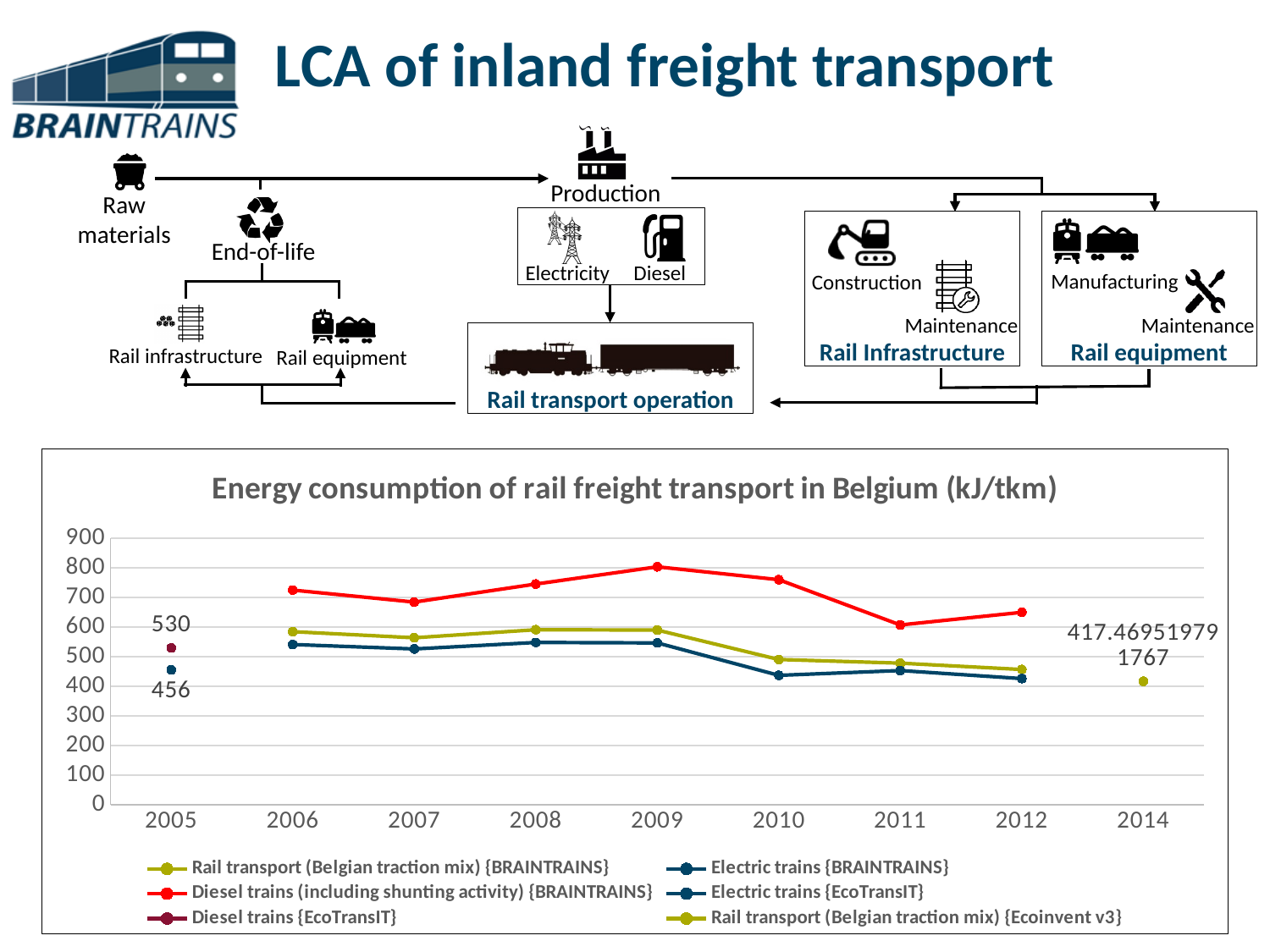
What is the difference between the Diesel trains {EcoTransIT} and Electric trains {EcoTransIT} values in 2005? 74 What is the value for Diesel trains {EcoTransIT} in 2005? 530 In which year does the Diesel trains (including shunting activity) {BRAINTRAINS} series reach its highest value? 2009 Is the value for Electric trains {BRAINTRAINS} in 2010 greater or less than 500? less How many series does the chart legend list? 6 In 2005, which is larger: the Diesel trains {EcoTransIT} value or the Electric trains {EcoTransIT} value? Diesel trains {EcoTransIT} What is the title of the chart? Energy consumption of rail freight transport in Belgium (kJ/tkm) What is the value for Electric trains {EcoTransIT} in 2005? 456 Does the Diesel trains (including shunting activity) {BRAINTRAINS} series rise or fall from 2009 to 2011? fall Is the value for Diesel trains (including shunting activity) {BRAINTRAINS} in 2010 greater or less than 700? greater What type of chart is shown on the slide? line chart How many years are shown on the x axis of the chart? 9